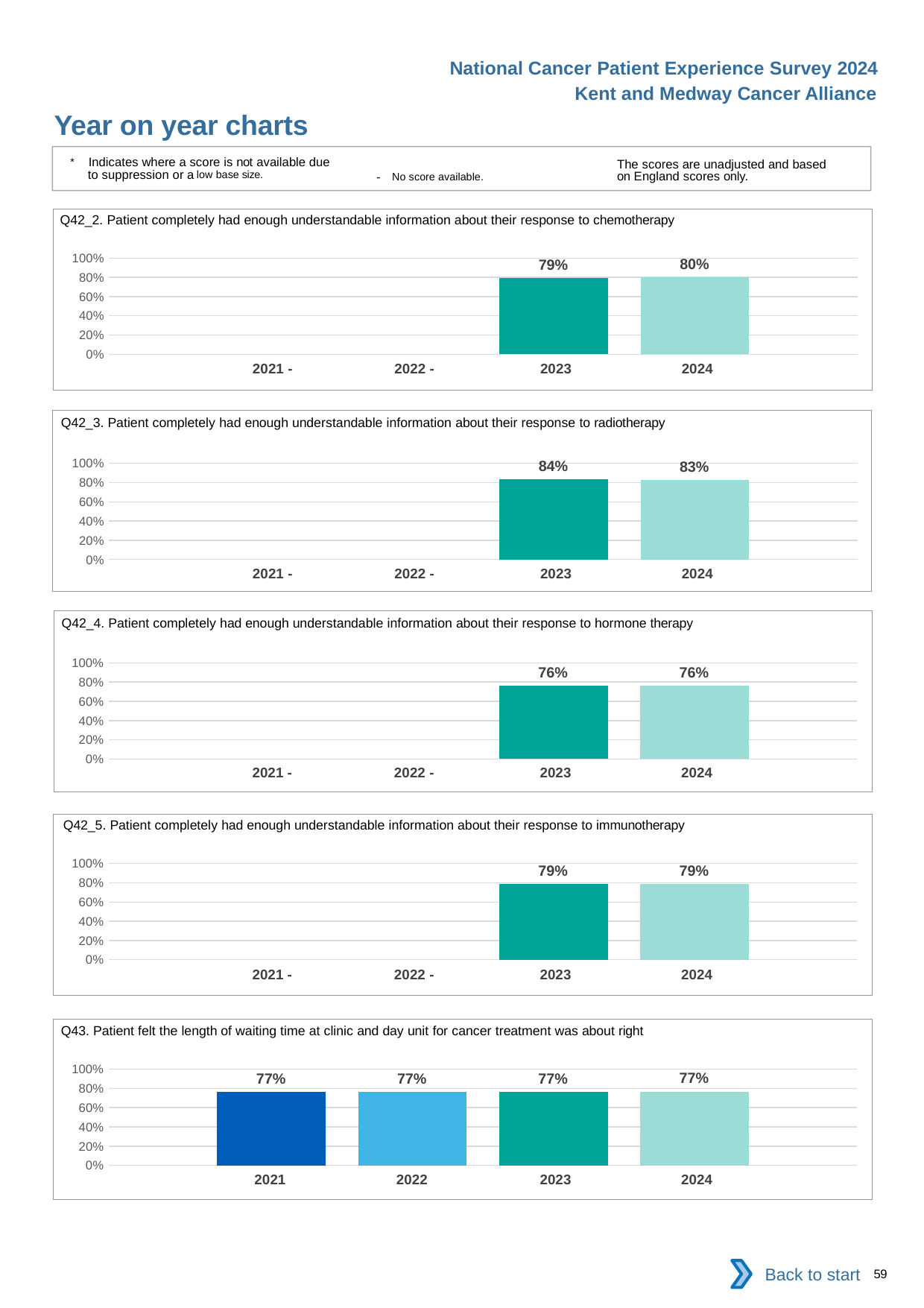
What kind of chart is the Q43 chart (waiting time at clinic and day unit)? bar chart In the Q43 chart (waiting time at clinic and day unit), how many years have a bar plotted? 4 In the Q42_5 chart (immunotherapy), what is the value for 2023? 79% In the Q42_3 chart (radiotherapy), what is the value for 2023? 84% In the Q42_4 chart (hormone therapy), how many years have a bar plotted? 2 In the Q43 chart (waiting time at clinic and day unit), do the values rise, fall or stay the same from 2021 to 2024? stay the same In the Q43 chart (waiting time at clinic and day unit), what is the value for 2021? 77% In the Q42_3 chart (radiotherapy), which year has the higher value, 2023 or 2024? 2023 In the Q42_4 chart (hormone therapy), what is the value for 2024? 76% In the Q42_5 chart (immunotherapy), is the value for 2024 greater or less than 60%? greater In the Q42_2 chart (chemotherapy), what is the value for 2024? 80% In the Q42_2 chart (chemotherapy), what is the difference between the 2024 and 2023 values? 1%